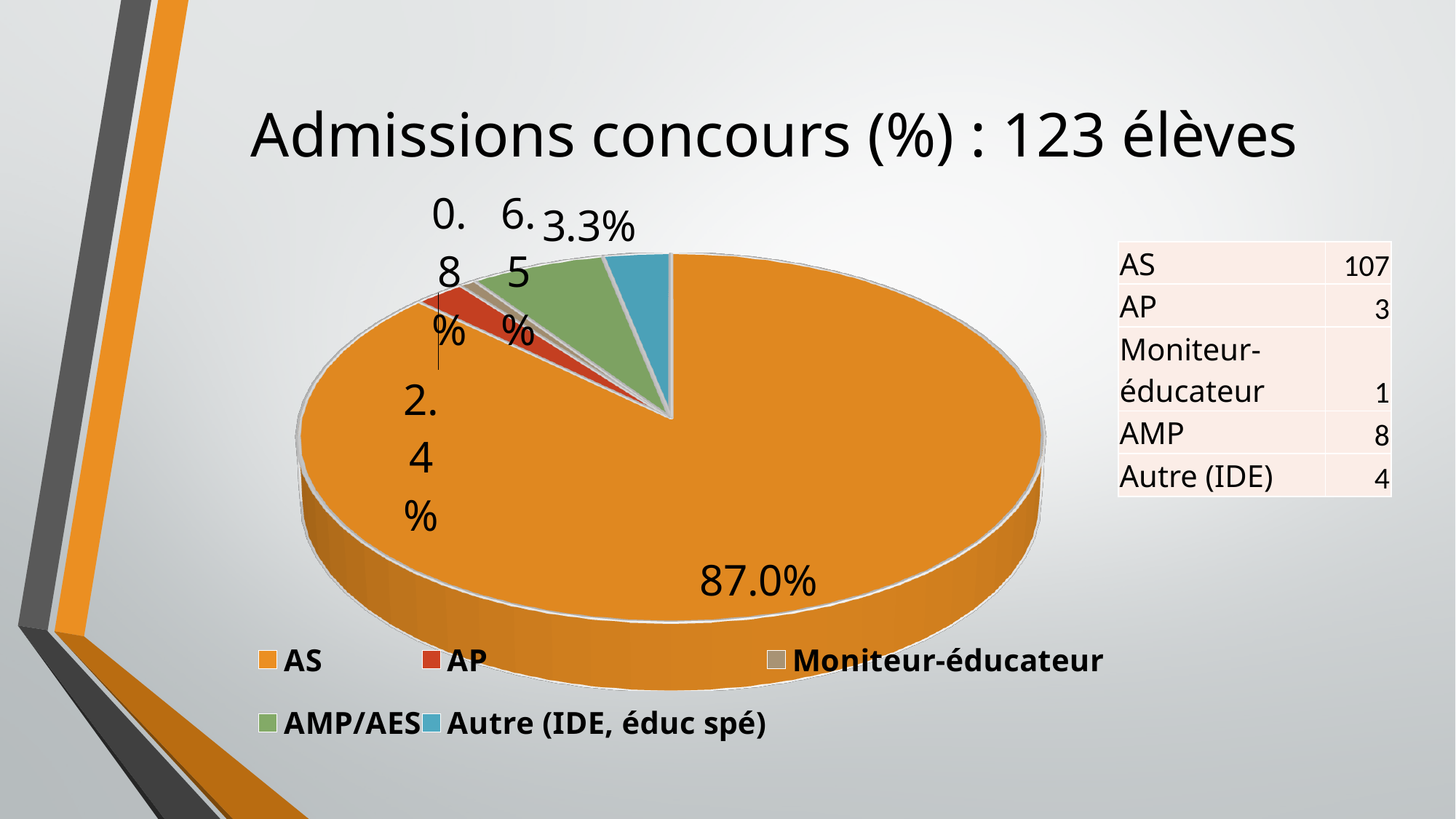
What percentage is shown for the AMP/AES slice? 6.5% Which category has the smallest slice of the pie? Moniteur-éducateur What percentage is shown for the Autre (IDE, éduc spé) slice? 3.3% What percentage is shown for the AP slice? 2.4% What percentage of the pie does the AS slice represent? 87.0% What kind of chart is shown on the slide? pie chart Which category has the largest slice of the pie? AS What is the difference in percentage points between the AS slice and the AMP/AES slice? 80.5 What percentage is shown for the Moniteur-éducateur slice? 0.8% Which slice is larger, AMP/AES or Autre (IDE, éduc spé)? AMP/AES How many slices does the pie chart have? 5 What is the title of the chart? Admissions concours (%) : 123 élèves